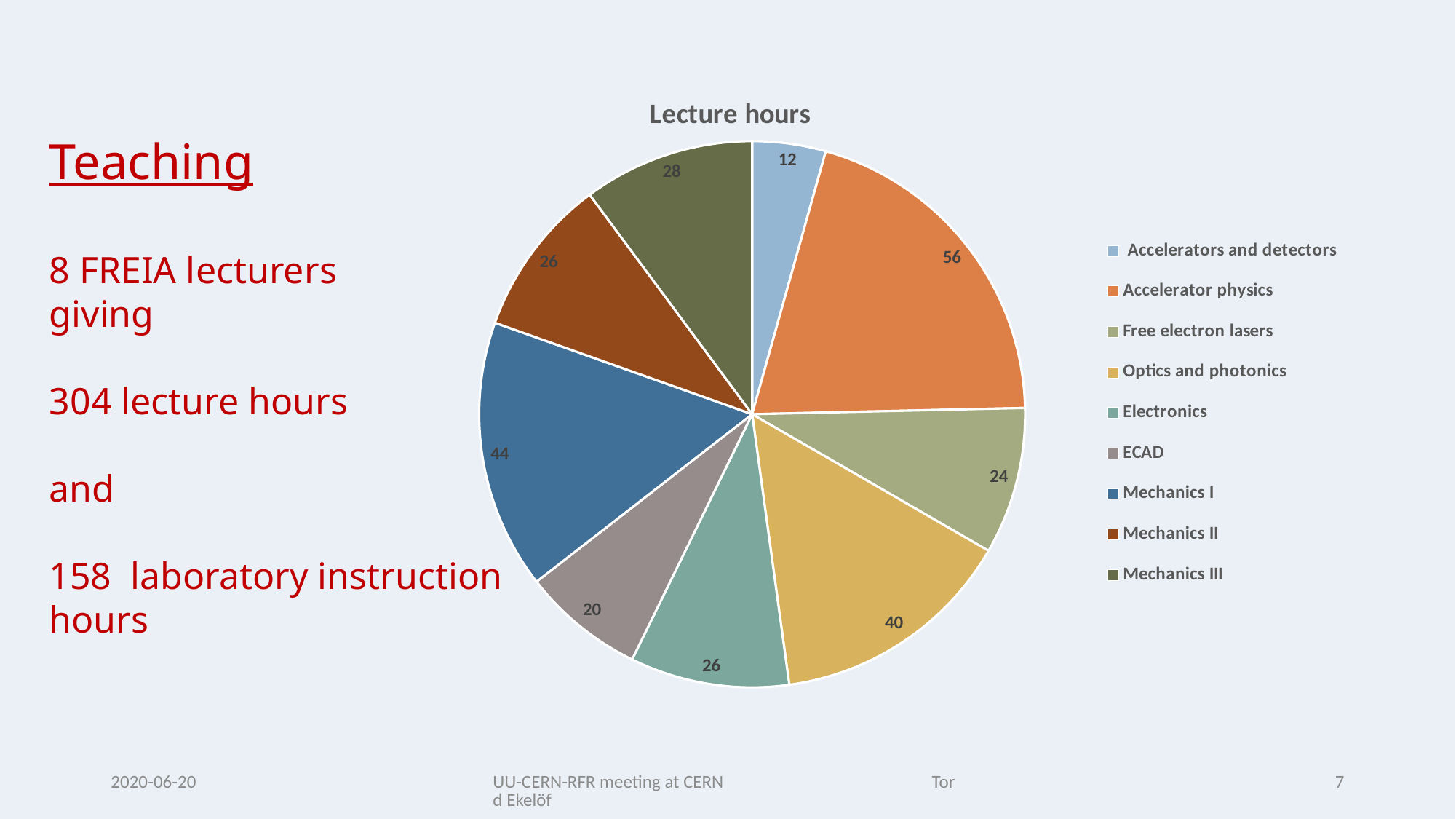
What is the difference in lecture hours between Mechanics III and Free electron lasers? 4 Which category has the smallest slice of the pie? Accelerators and detectors What is the difference in lecture hours between Accelerator physics and Accelerators and detectors? 44 What type of chart is shown on the slide? pie chart Which has more lecture hours, Mechanics I or Optics and photonics? Mechanics I How many categories does the pie chart have? 9 How many lecture hours are shown for Accelerator physics? 56 How many lecture hours are shown for Optics and photonics? 40 Which category has the largest slice of the pie? Accelerator physics How many lecture hours are shown for ECAD? 20 What is the title of the chart? Lecture hours How many lecture hours are shown for Mechanics I? 44